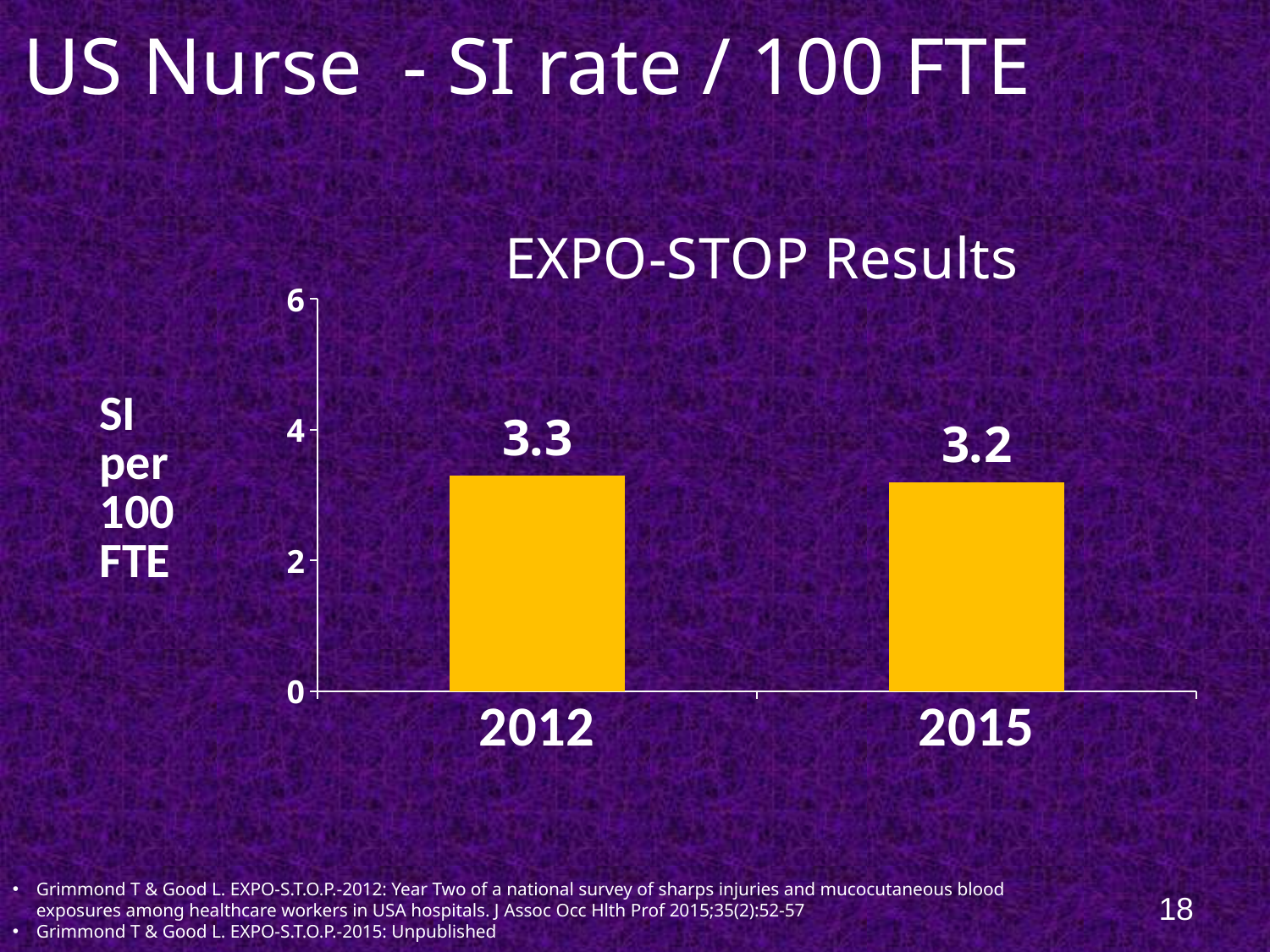
Is the SI rate for 2012 greater or less than 4? less What is the SI rate per 100 FTE for 2015? 3.2 Is the SI rate for 2015 greater or less than 2? greater What kind of chart is shown on the slide? Bar chart What is the label on the vertical axis of the chart? SI per 100 FTE Does the SI rate rise or fall from 2012 to 2015? Fall What is the difference between the 2012 and 2015 SI rates per 100 FTE? 0.1 Which year has the lower SI rate per 100 FTE? 2015 What is the title of the chart? EXPO-STOP Results How many years are shown on the chart? 2 Which year has the higher SI rate per 100 FTE? 2012 What is the SI rate per 100 FTE for 2012? 3.3